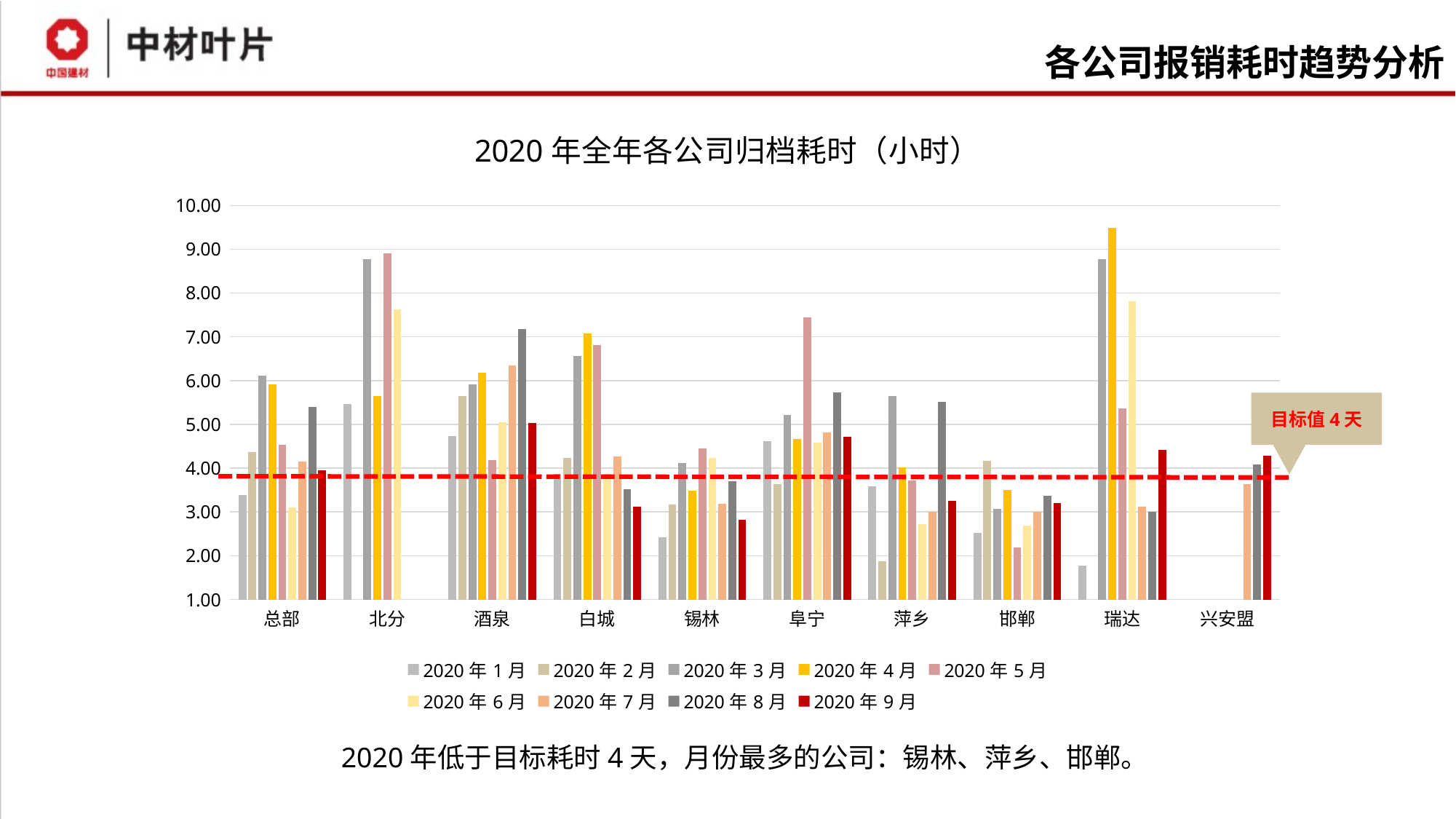
Is the value for 锡林 in 2020 年 1 月 greater or less than 3.00? less Is the value for 北分 in 2020 年 3 月 greater or less than 8.00? greater Is the value for 阜宁 in 2020 年 5 月 greater or less than 7.00? greater What is the title of the chart? 2020 年全年各公司归档耗时（小时） How many series does the legend list? 9 Which company has the tallest bar in the chart? 瑞达 How many companies (categories) are shown on the x axis? 10 Which is larger for 瑞达: the value for 2020 年 4 月 or the value for 2020 年 6 月? 2020 年 4 月 Which is larger for 2020 年 3 月: the value for 北分 or the value for 总部? 北分 What kind of chart is shown on the slide? bar chart What target value does the callout next to the dashed red line state? 目标值 4 天